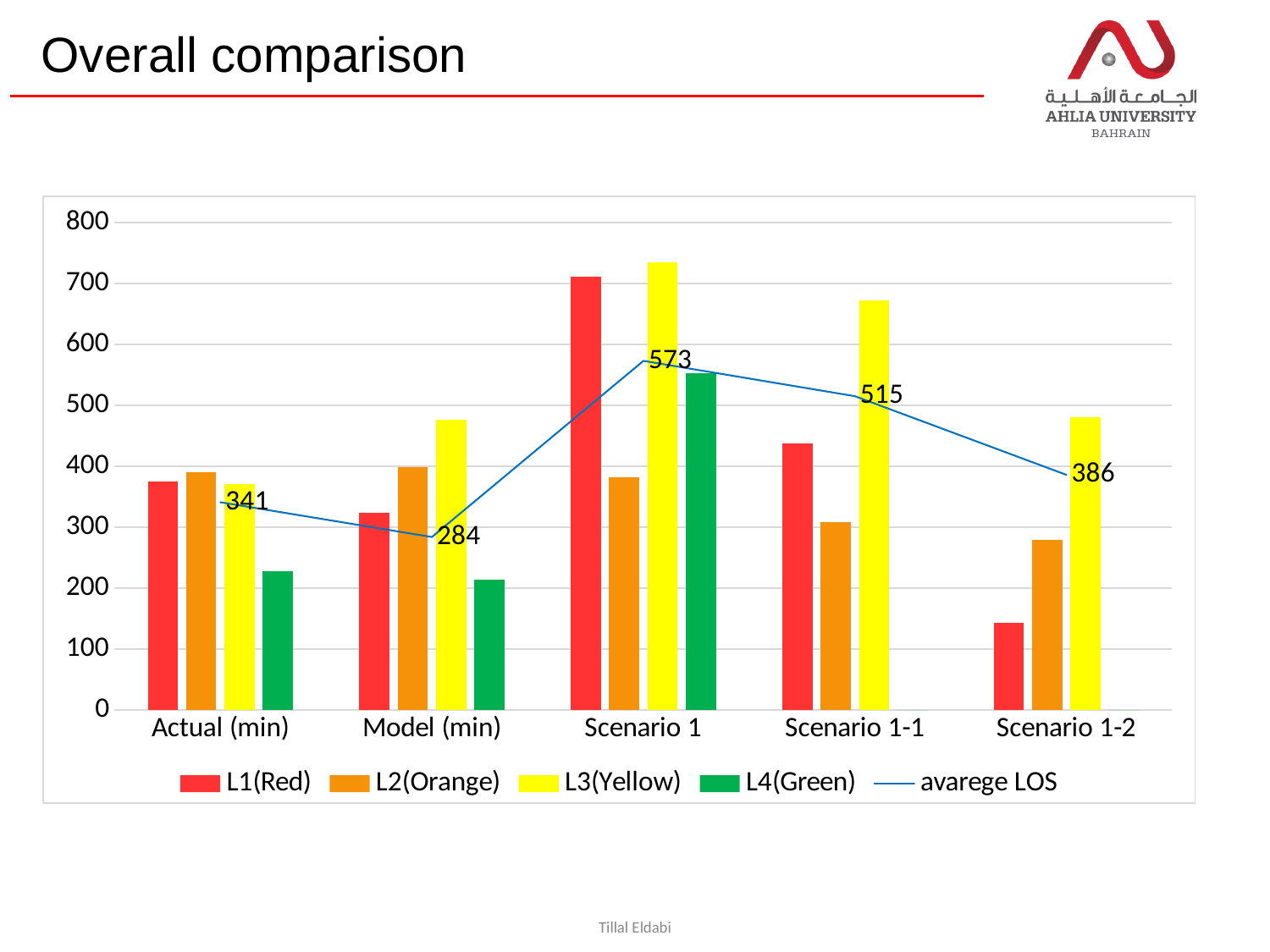
Which category has the lowest avarege LOS value? Model (min) What is the avarege LOS value for Scenario 1-2? 386 What is the avarege LOS value for Scenario 1? 573 Does the avarege LOS line rise or fall from Scenario 1 to Scenario 1-2? fall What is the difference between the avarege LOS values for Scenario 1 and Model (min)? 289 Is the L3(Yellow) value for Scenario 1 greater or less than 700? greater Which category has the highest avarege LOS value? Scenario 1 What is the avarege LOS value for Model (min)? 284 How many categories are shown on the x axis? 5 Which has a larger avarege LOS value, Actual (min) or Model (min)? Actual (min) Is the L1(Red) value for Scenario 1-2 greater or less than 200? less How many series does the legend list? 5